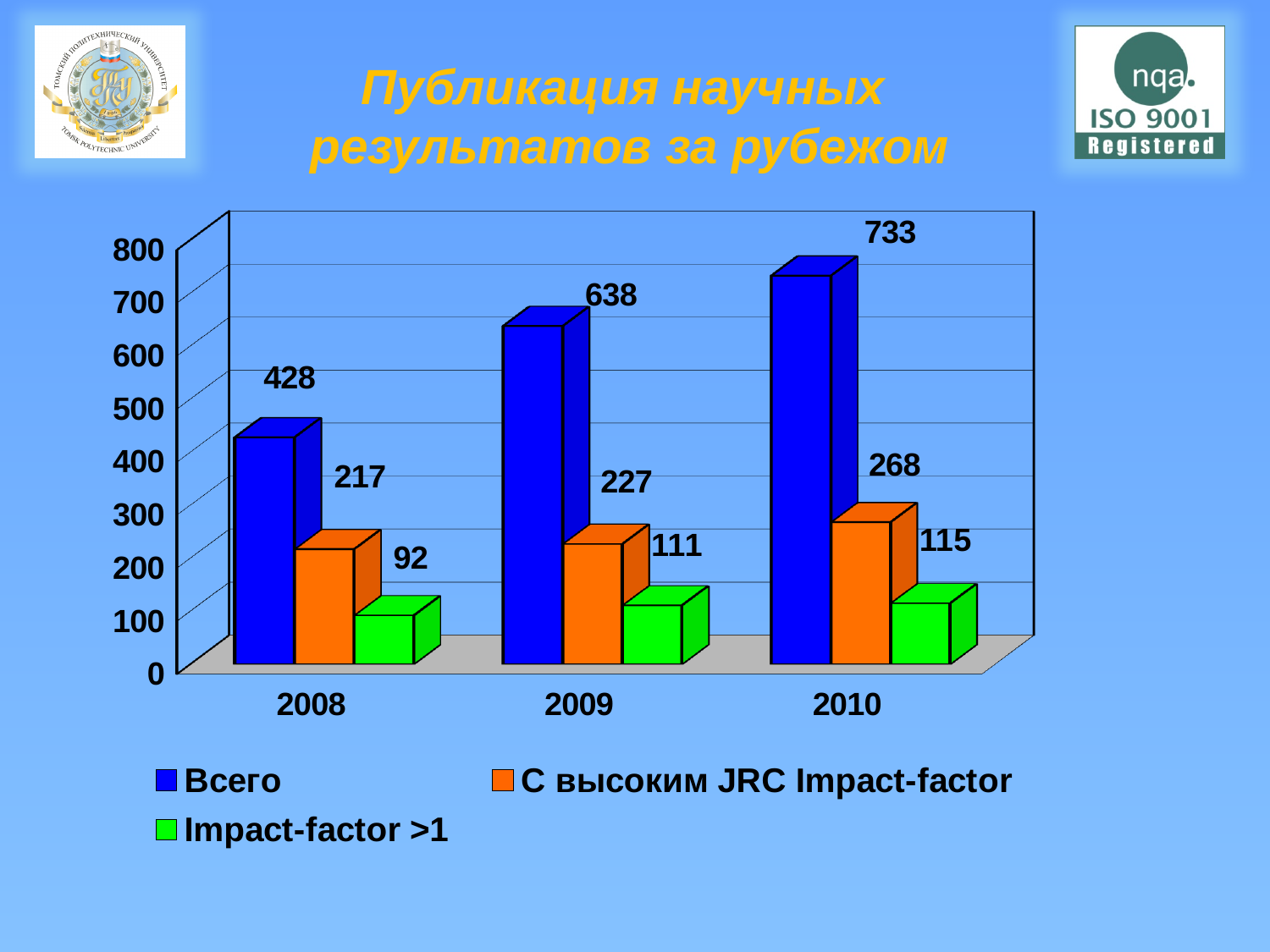
Is the "Всего" value for 2009 greater or less than 600? greater In which year is the "Impact-factor >1" value lowest? 2008 How many years are shown on the x axis? 3 What is the value of "Всего" for 2010? 733 Which is larger: "С высоким JRC Impact-factor" in 2010 or in 2009? 2010 Does the "Всего" series rise or fall from 2008 to 2010? rise What kind of chart is shown on the slide? bar chart What is the value of "Impact-factor >1" for 2009? 111 In which year is the "Всего" value highest? 2010 What is the difference between the "Всего" values for 2009 and 2008? 210 How many series does the legend list? 3 What is the value of "С высоким JRC Impact-factor" for 2008? 217